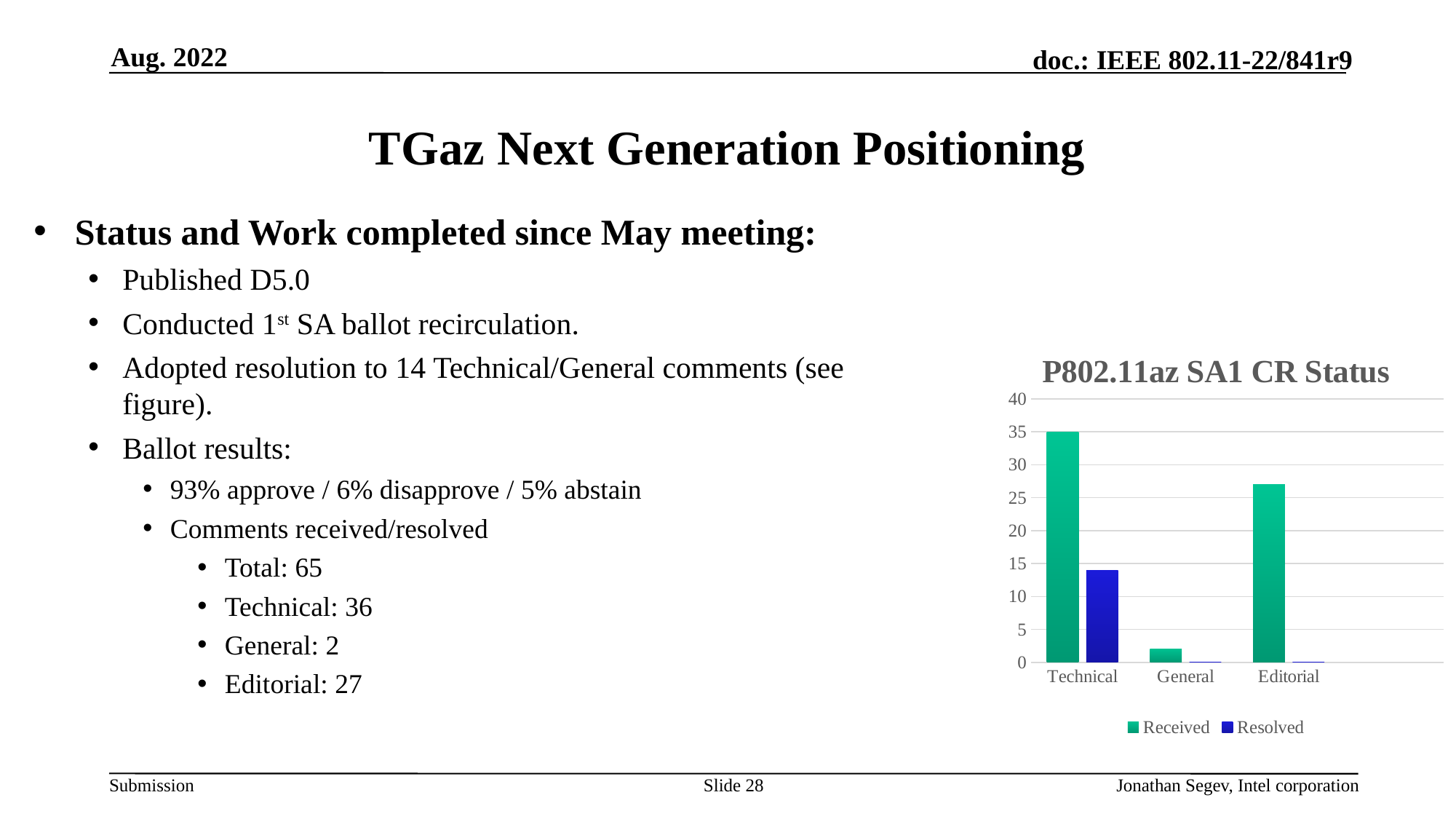
Is the Resolved value for Technical greater or less than 10? greater Is the Received value for General greater or less than 5? less Is the Received value for Technical greater or less than 30? greater What is the title of the chart? P802.11az SA1 CR Status How many series does the chart legend list? 2 What kind of chart is shown on the slide? bar chart Which category has the highest Received value? Technical Which series is shown in blue in the chart? Resolved How many categories are shown on the x axis of the chart? 3 Which category has the lowest Received value? General Which is larger, the Received value for Technical or the Received value for Editorial? Technical